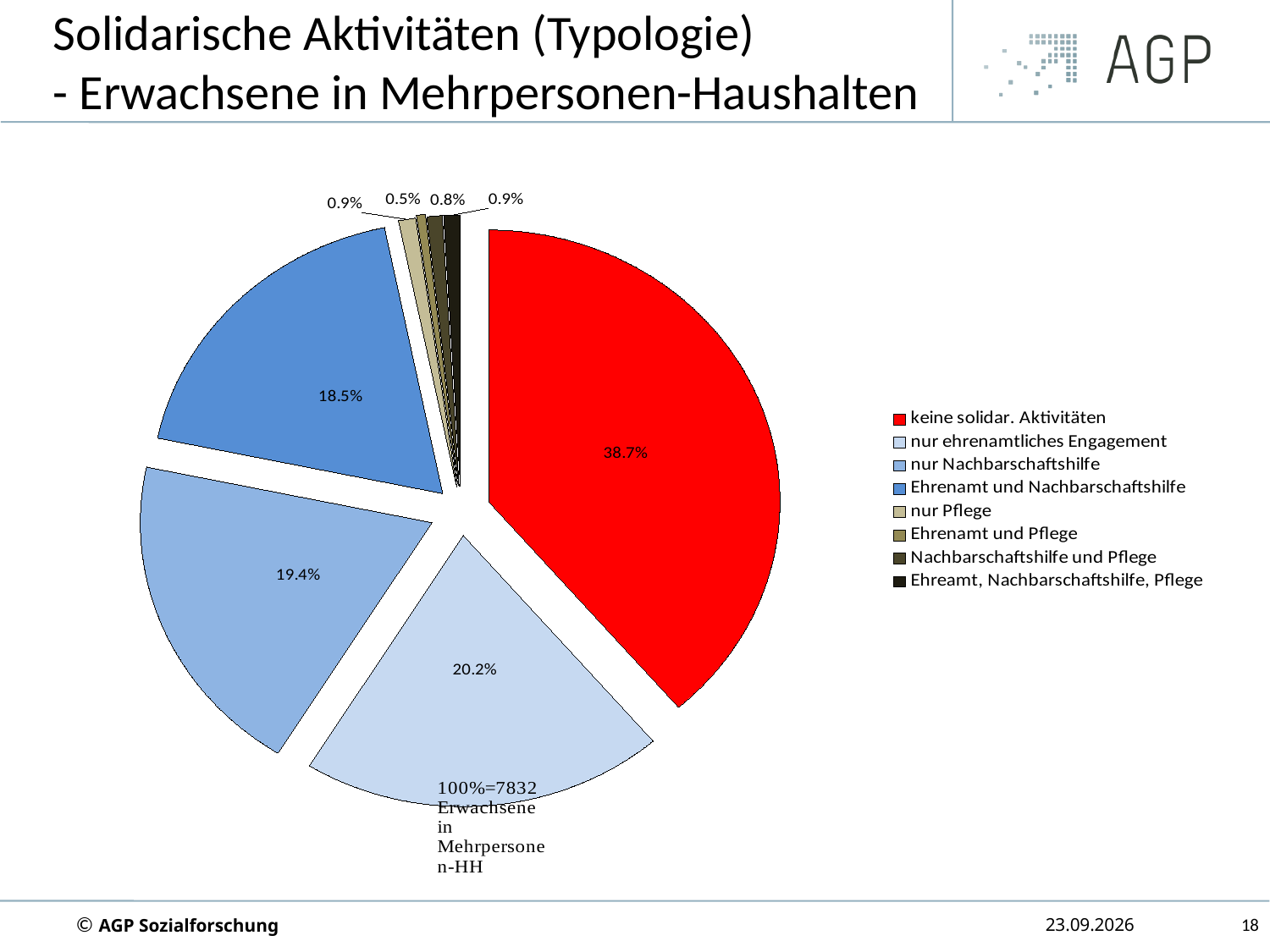
What is the smallest percentage labelled on the pie? 0.5% Which is larger: the share for 'nur Nachbarschaftshilfe' or for 'Ehrenamt und Nachbarschaftshilfe'? nur Nachbarschaftshilfe How many categories does the legend list? 8 What percentage is shown for 'Ehrenamt und Nachbarschaftshilfe'? 18.5% Which category has the largest slice of the pie? keine solidar. Aktivitäten What share of the pie is labelled for 'keine solidar. Aktivitäten'? 38.7% What colour is the slice for 'keine solidar. Aktivitäten'? red What is the difference in percentage points between 'keine solidar. Aktivitäten' (38.7%) and 'nur ehrenamtliches Engagement' (20.2%)? 18.5 What kind of chart is shown on the slide? pie chart According to the note on the chart, how many adults does 100% correspond to? 7832 What percentage is shown for 'nur Nachbarschaftshilfe'? 19.4% What percentage is shown for 'nur ehrenamtliches Engagement'? 20.2%